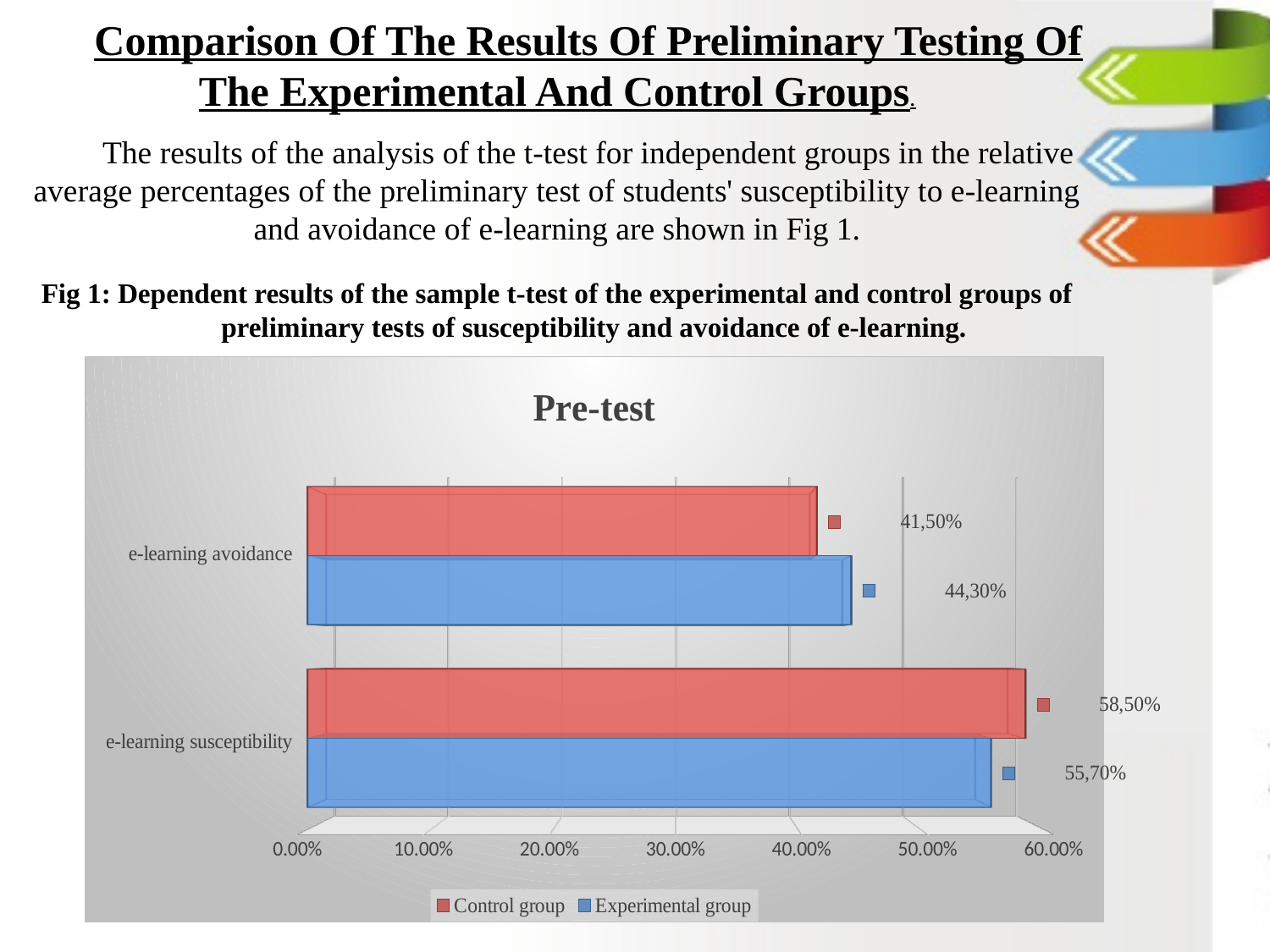
Which group has the higher value for e-learning susceptibility? Control group How many series does the legend list? 2 How many categories are shown on the chart? 2 What is the value for the Experimental group for e-learning susceptibility? 55,70% What is the chart title? Pre-test What is the value for the Experimental group for e-learning avoidance? 44,30% What is the difference between the Control group and Experimental group values for e-learning susceptibility? 2,80% What type of chart is shown on the slide? bar chart What is the value for the Control group for e-learning avoidance? 41,50% Which colour represents the Control group in the legend? red What is the value for the Control group for e-learning susceptibility? 58,50% Which group has the higher value for e-learning avoidance? Experimental group